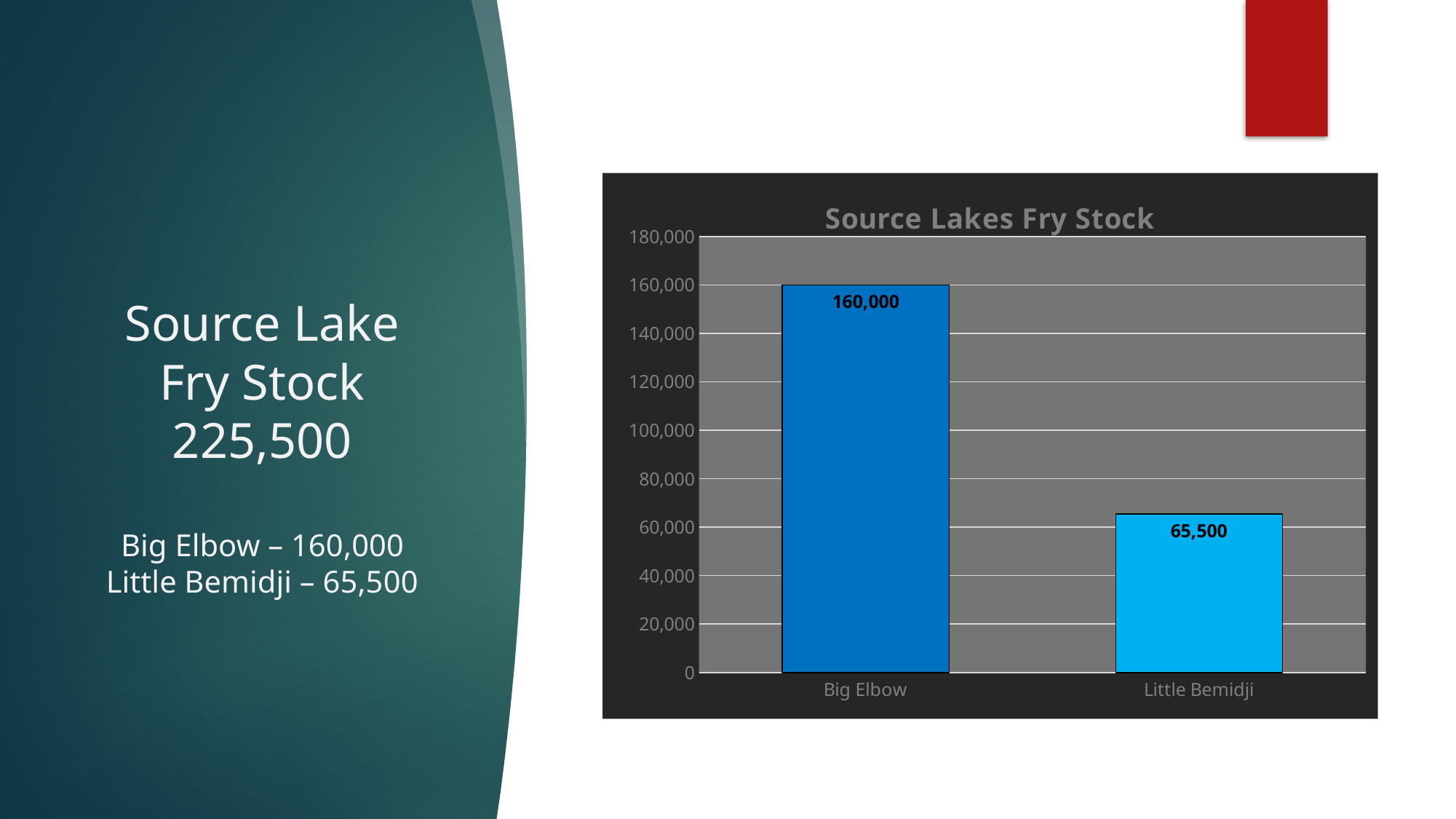
What is the difference between the fry stock of Big Elbow and Little Bemidji? 94,500 Which lake has the lowest fry stock? Little Bemidji Which is larger, the fry stock for Big Elbow or for Little Bemidji? Big Elbow What is the title of the chart? Source Lakes Fry Stock Is the value for Little Bemidji greater or less than 80,000? less What is the fry stock value for Little Bemidji? 65,500 What kind of chart is shown on the slide? Bar chart Which lake has the highest fry stock? Big Elbow How many lakes are shown in the chart? 2 What is the fry stock value for Big Elbow? 160,000 What is the total fry stock across both lakes shown in the chart? 225,500 Is the value for Big Elbow greater or less than 140,000? greater